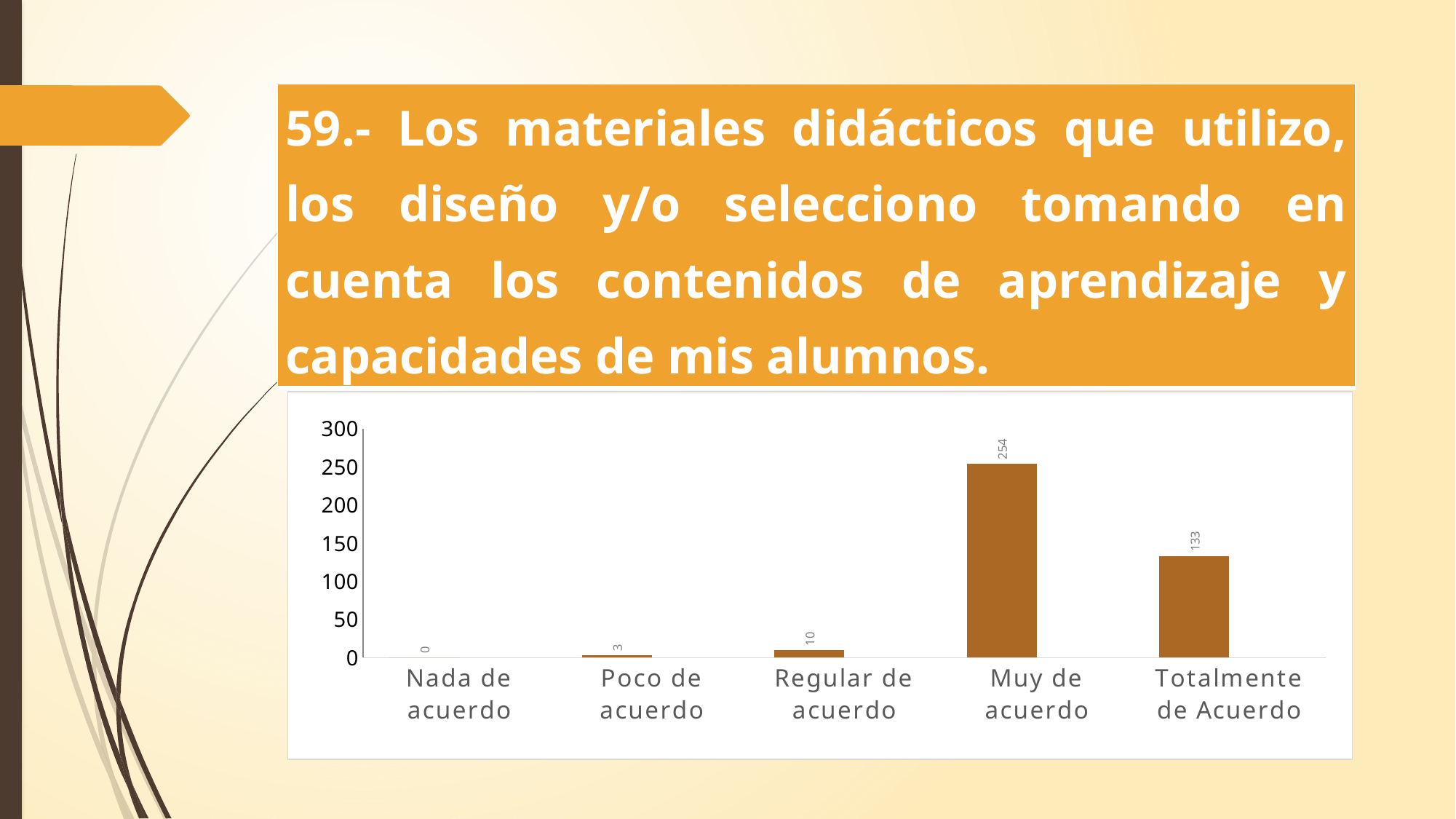
Which is larger, the value for "Regular de acuerdo" or the value for "Poco de acuerdo"? Regular de acuerdo Is the value for "Totalmente de Acuerdo" greater or less than 150? less Which category has the highest value? Muy de acuerdo What kind of chart is shown on the slide? bar chart Which category has the lowest value? Nada de acuerdo How many categories are shown on the x axis? 5 What is the value for "Totalmente de Acuerdo"? 133 What is the value for "Poco de acuerdo"? 3 What is the difference between the values for "Muy de acuerdo" and "Totalmente de Acuerdo"? 121 What is the value for "Muy de acuerdo"? 254 What is the value for "Regular de acuerdo"? 10 What is the value for "Nada de acuerdo"? 0